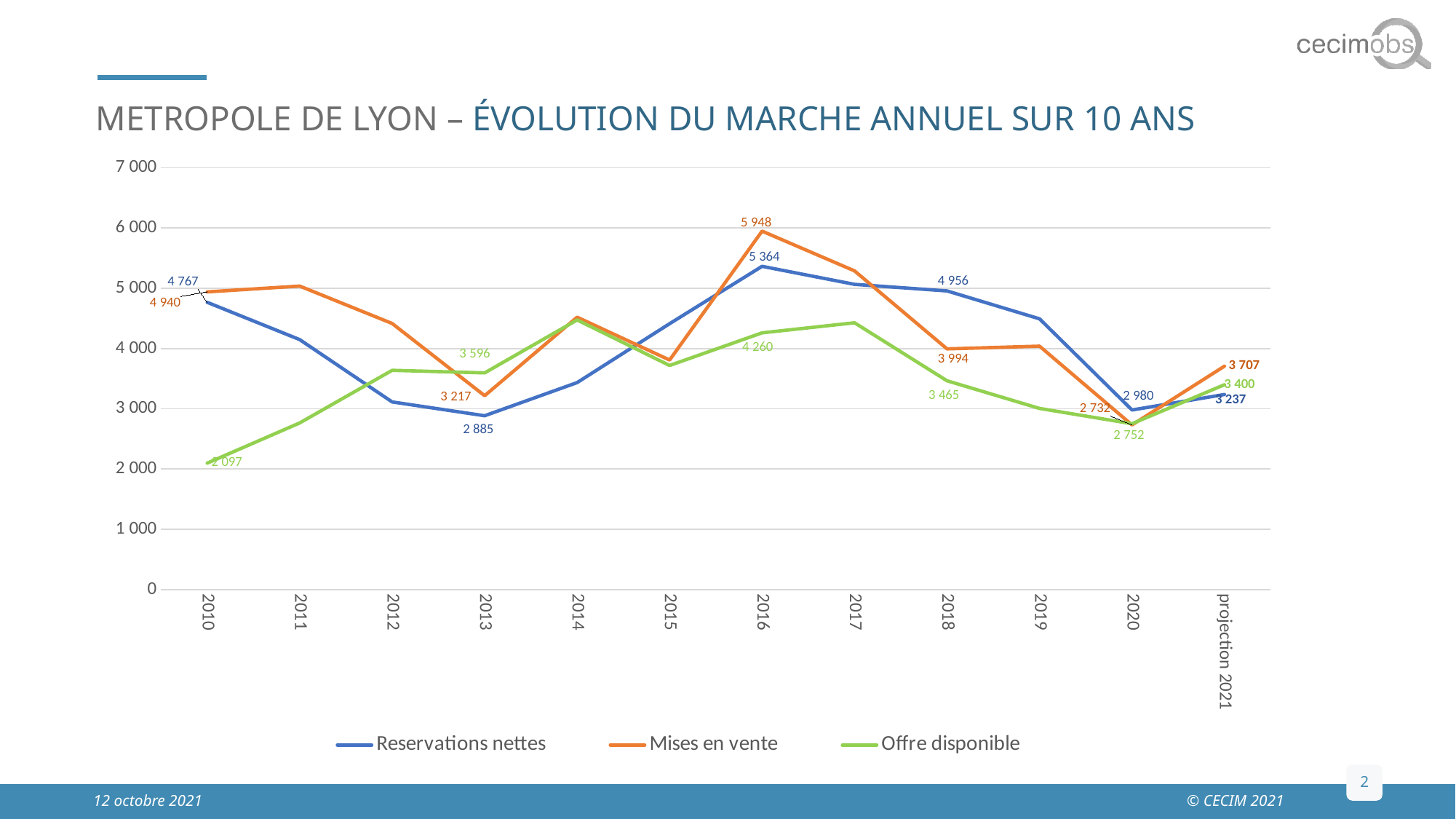
What colour is the Offre disponible line? green How many series does the legend list? 3 Is the value of Offre disponible in 2017 greater or less than 4 000? greater What kind of chart is shown on the slide? line chart What is the value of Reservations nettes in 2013? 2 885 What is the value of Mises en vente for projection 2021? 3 707 How many points are shown along the x axis? 12 In 2020, which is larger: Reservations nettes or Mises en vente? Reservations nettes What is the value of Offre disponible in 2010? 2 097 In which year does Mises en vente reach its highest value? 2016 In 2016, how much higher is Mises en vente than Reservations nettes? 584 What is the value of Mises en vente in 2016? 5 948